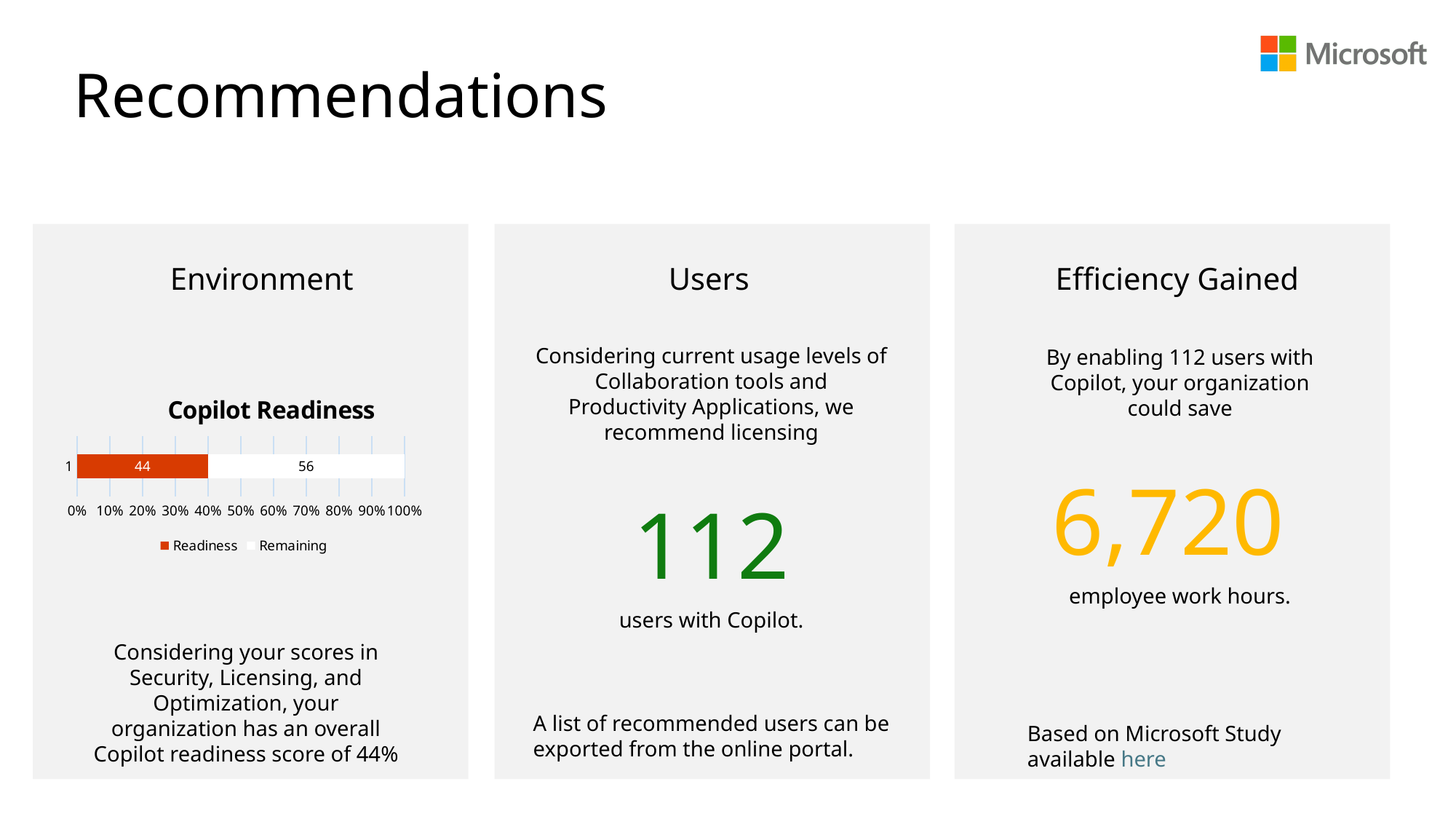
Is the Readiness value in the Copilot Readiness chart greater or less than 50%? less How many bars are plotted in the Copilot Readiness chart? 1 In the Copilot Readiness chart, what is the value of the Remaining series? 56 What is the title of the chart on the slide? Copilot Readiness In the Copilot Readiness chart, what is the value of the Readiness series? 44 How many series does the legend of the Copilot Readiness chart list? 2 What is the total of the stacked bar in the Copilot Readiness chart? 100 Which series in the Copilot Readiness chart has the larger value, Readiness or Remaining? Remaining What colour is the Readiness series in the Copilot Readiness chart? red-orange In the Copilot Readiness chart, what is the difference between the Remaining value and the Readiness value? 12 What kind of chart is the Copilot Readiness chart? bar chart What is the highest value shown on the x axis of the Copilot Readiness chart? 100%